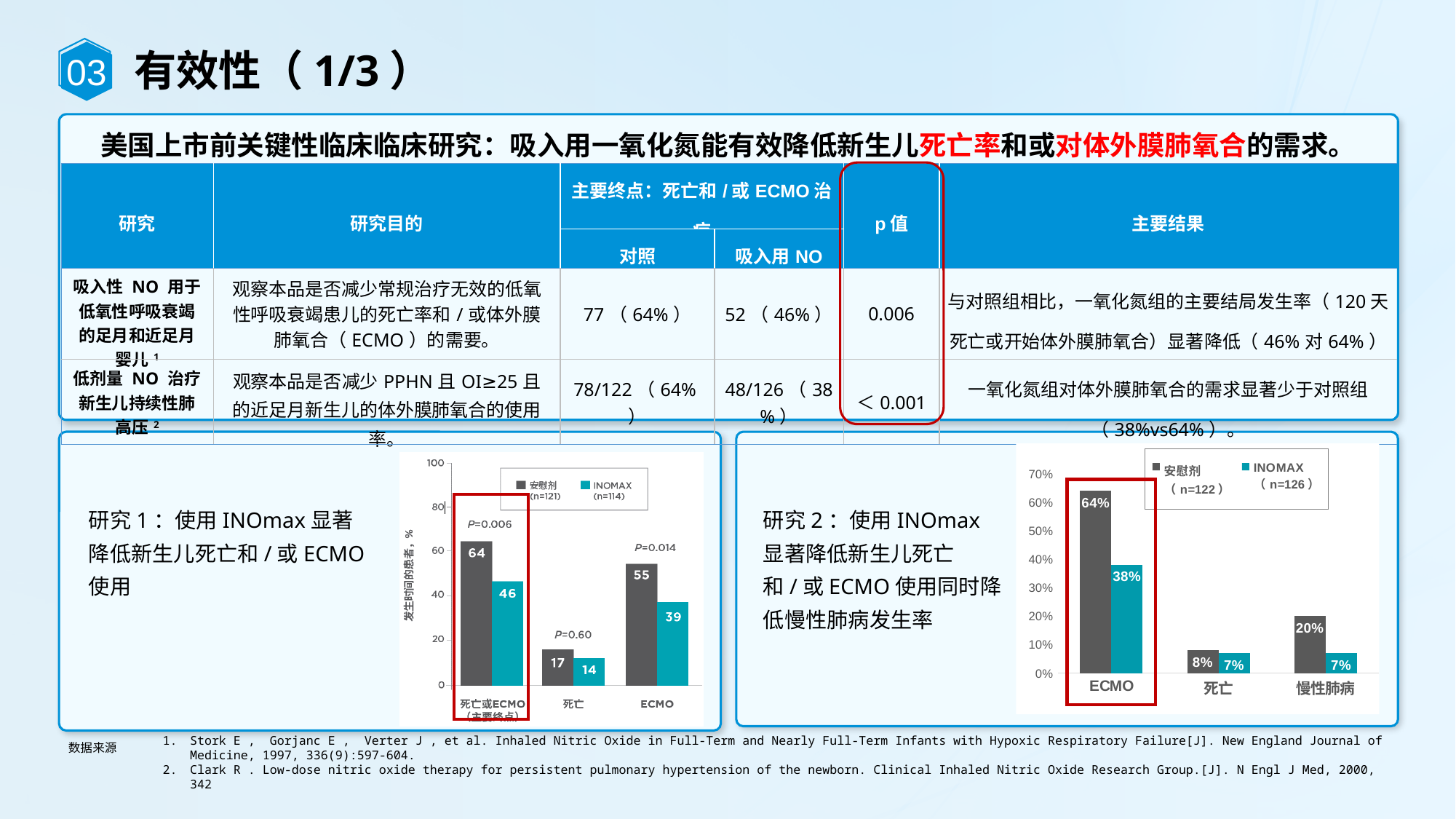
In the left chart (研究 1), what is the value for INOMAX in the ECMO category? 39 In the right chart (研究 2), what is the value for 安慰剂 in the 慢性肺病 category? 20% In the left chart (研究 1), what is the value for 安慰剂 in the 死亡或ECMO category? 64 In the left chart (研究 1), what is the difference between the 安慰剂 and INOMAX values in the 死亡 category? 3 In the right chart (研究 2), how many categories are shown on the x axis? 3 In the left chart (研究 1), what P value is shown above the ECMO category? P=0.014 In the right chart (研究 2), what is the value for INOMAX in the ECMO category? 38% In the right chart (研究 2), what is the difference between the 安慰剂 and INOMAX values in the ECMO category? 26% In the right chart (研究 2), which category has the highest 安慰剂 value? ECMO What type of chart is the right chart (研究 2)? Bar chart In the left chart (研究 1), which category has the lowest INOMAX value? 死亡 In the left chart (研究 1), how many series does the legend list? 2